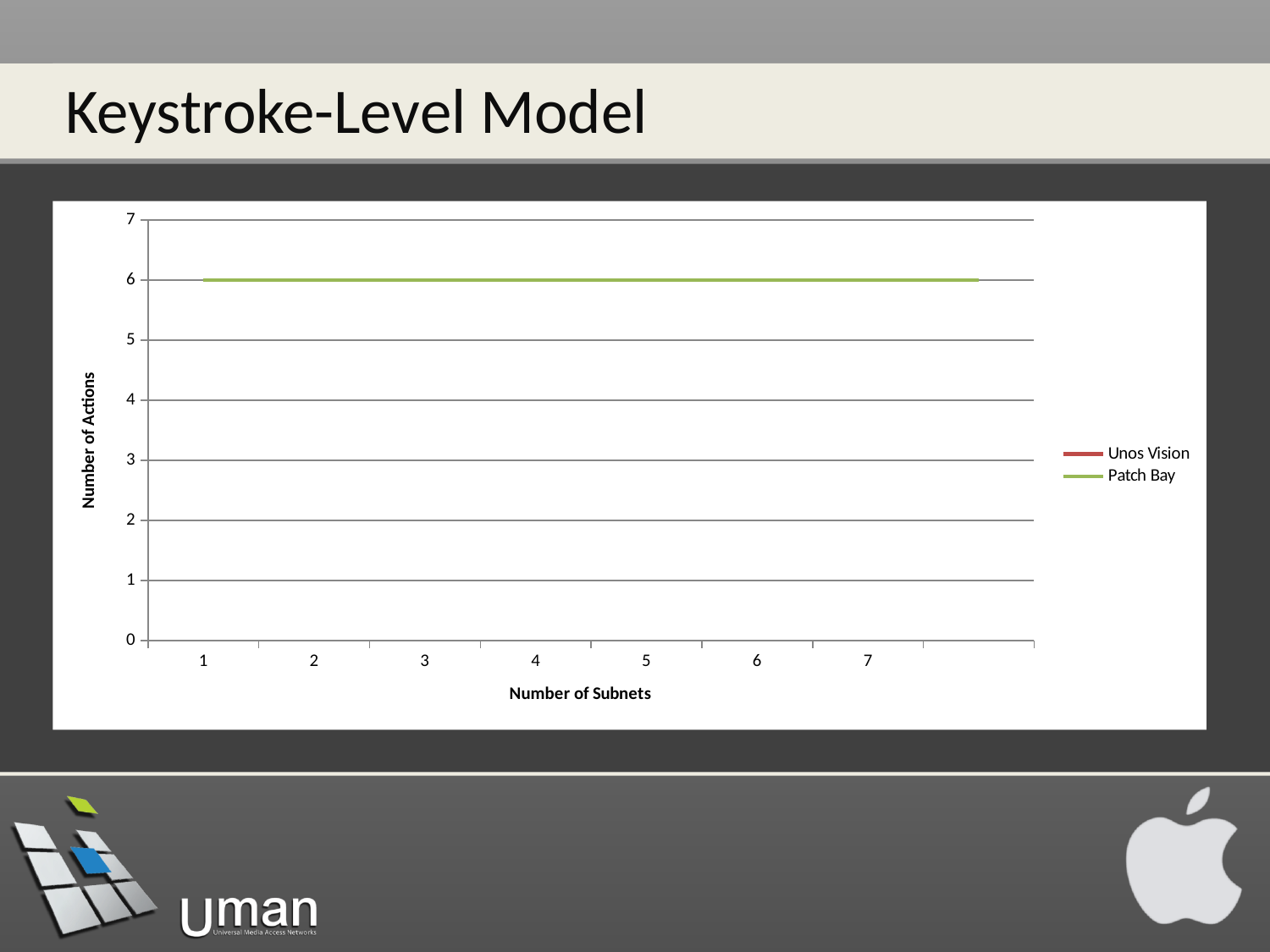
What is the Number of Actions for Patch Bay at 7 subnets? 6 What is the difference between the Patch Bay value at 1 subnet and at 7 subnets? 0 What kind of chart is shown on the slide? line chart What is the label on the vertical axis? Number of Actions What are the two series named in the legend? Unos Vision and Patch Bay What is the Number of Actions for Patch Bay at 1 subnet? 6 How many series does the legend list? 2 Does the Patch Bay line rise, fall, or stay flat as the number of subnets increases? stays flat Is the value for Patch Bay at 2 subnets greater or less than 7? less Is the value for Patch Bay at 5 subnets greater or less than 5? greater What is the Number of Actions for Patch Bay at 3 subnets? 6